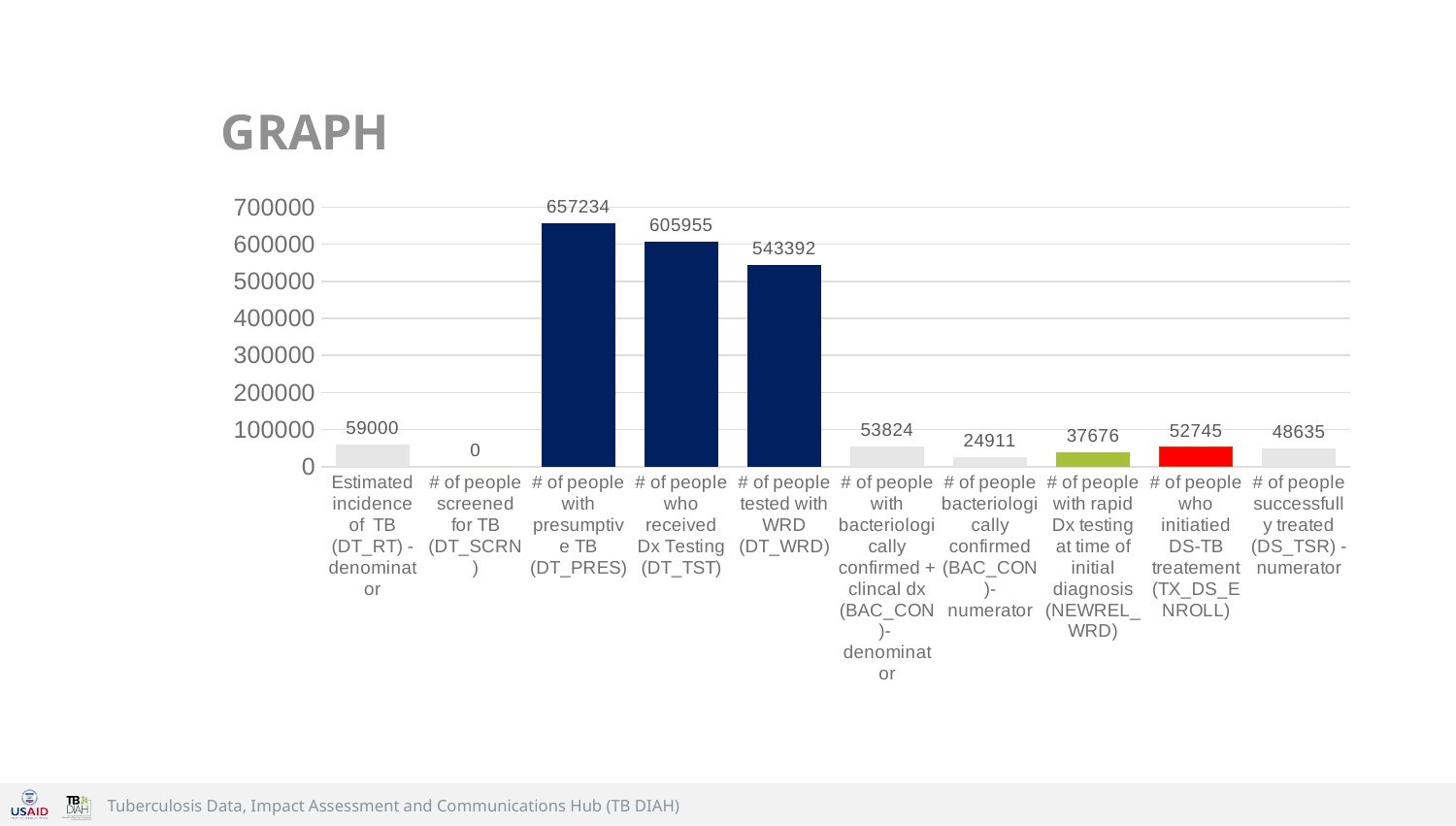
What is the title of the chart? GRAPH What is the value for # of people bacteriologically confirmed (BAC_CON) - numerator? 24911 Which category has the lowest value? # of people screened for TB (DT_SCRN) What is the value for # of people with presumptive TB (DT_PRES)? 657234 What is the difference between the values for # of people with presumptive TB (DT_PRES) and # of people who received Dx Testing (DT_TST)? 51279 Which is larger: the value for Estimated incidence of TB (DT_RT) - denominator or the value for # of people successfully treated (DS_TSR) - numerator? Estimated incidence of TB (DT_RT) - denominator What is the value for # of people who initiated DS-TB treatment (TX_DS_ENROLL)? 52745 Is the value for # of people who received Dx Testing (DT_TST) greater or less than 600000? greater How many categories are shown on the x axis? 10 Which category has the highest value? # of people with presumptive TB (DT_PRES) What type of chart is shown on the slide? bar chart What is the value for # of people tested with WRD (DT_WRD)? 543392